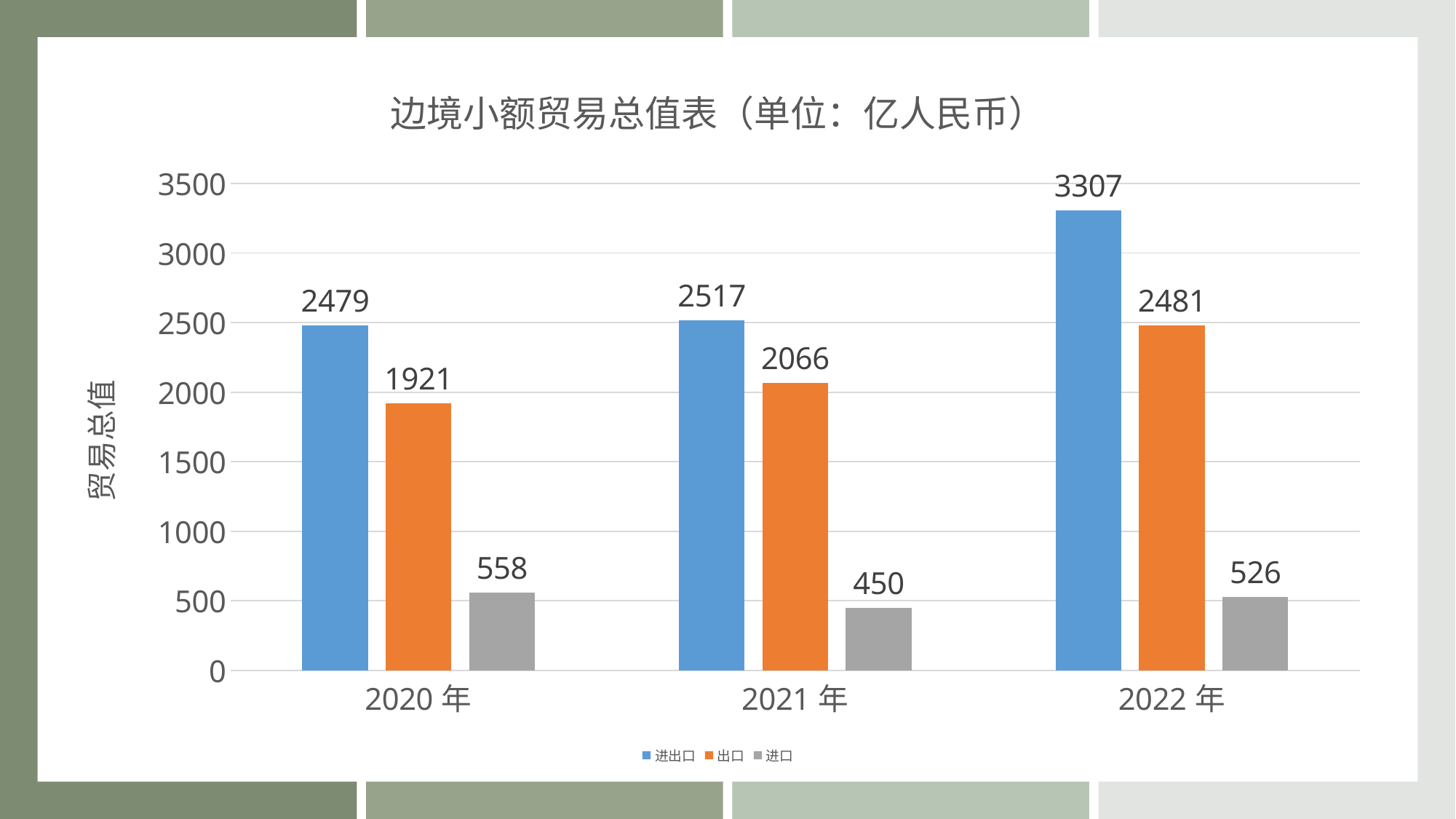
What is the difference between the 进出口 values for 2022 年 and 2021 年? 790 What is the value of 进口 for 2022 年? 526 Which is larger: 出口 in 2020 年 or 出口 in 2022 年? 出口 in 2022 年 Does the 进出口 value rise or fall from 2020 年 to 2022 年? rise What is the value of 出口 for 2021 年? 2066 Which year has the highest 进出口 value? 2022 年 Is the 进出口 value for 2022 年 greater or less than 3000? greater How many years are shown on the x axis? 3 What kind of chart is shown on the slide? bar chart Which year has the lowest 进口 value? 2021 年 How many series does the legend list? 3 What is the value of 进出口 for 2020 年? 2479